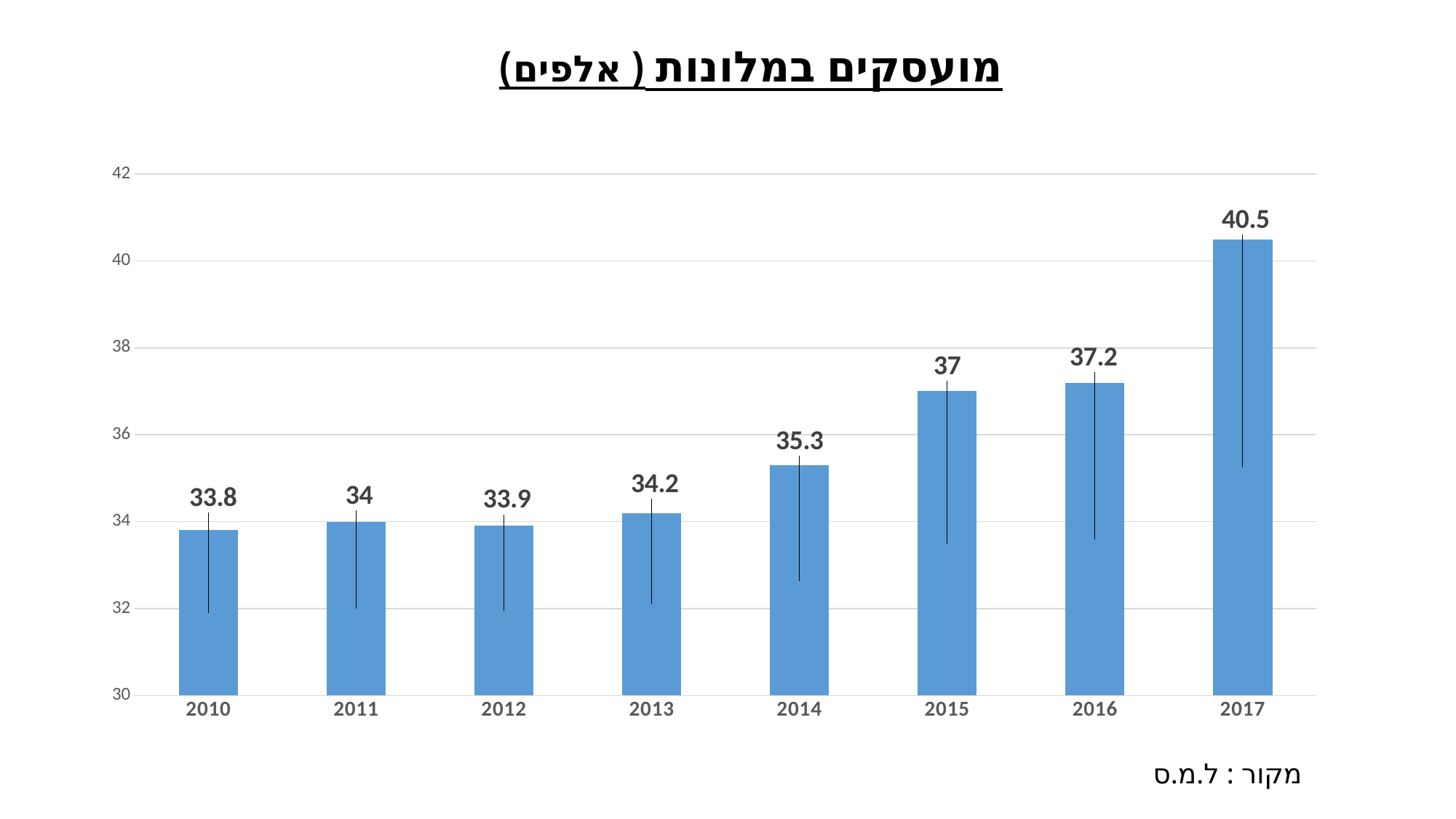
Which is larger, the value for 2012 or the value for 2014? 2014 Which year has the highest value? 2017 Do the values generally rise or fall from 2013 to 2017? rise What is the value for 2017? 40.5 How many years are shown on the x axis? 8 What is the value for 2014? 35.3 What is the difference between the values for 2017 and 2016? 3.3 Is the value for 2016 greater or less than 36? greater What is the difference between the values for 2015 and 2013? 2.8 What is the value for 2010? 33.8 Which year has the lowest value? 2010 What kind of chart is shown on the slide? bar chart